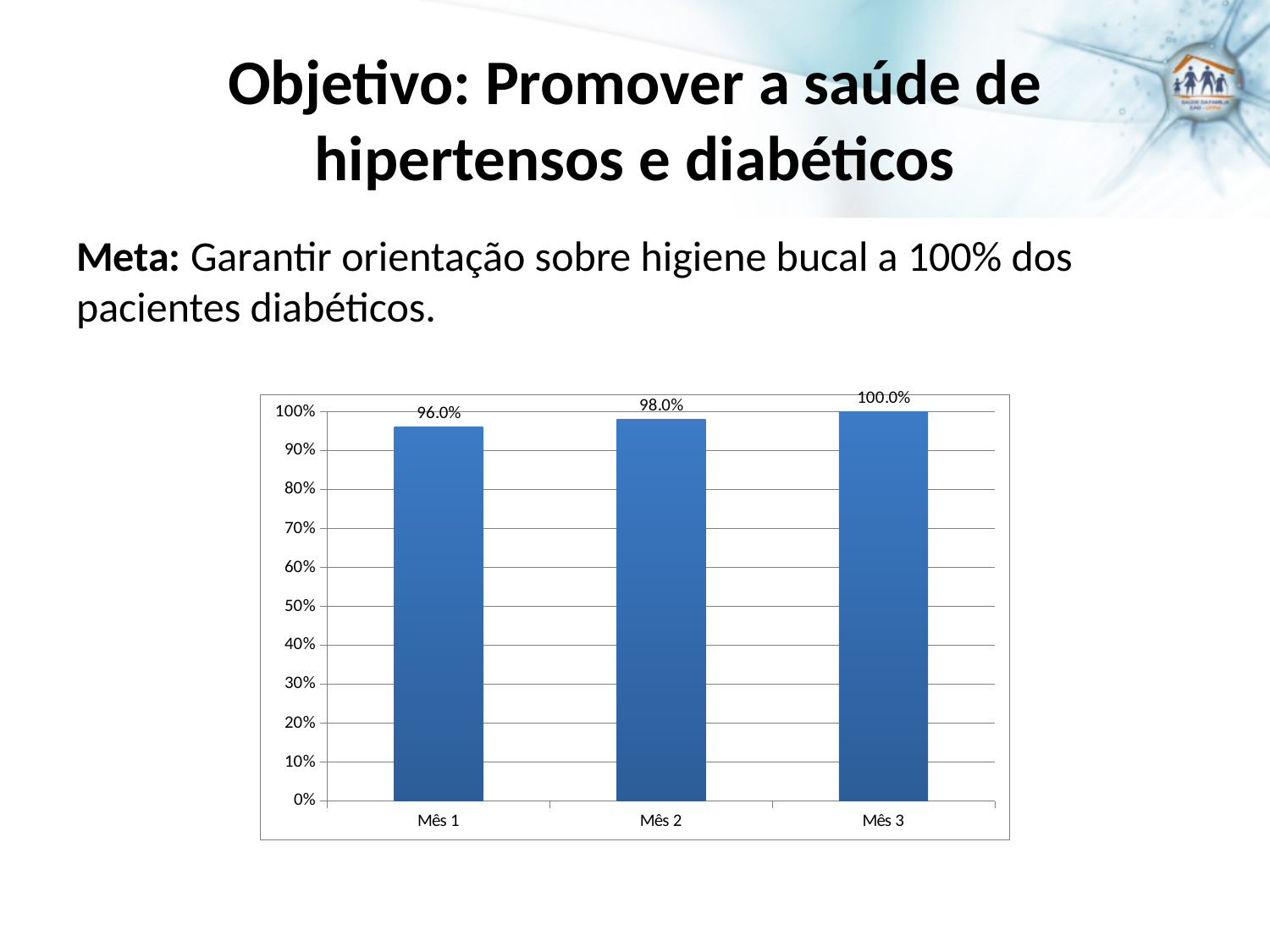
How many categories are shown on the x axis? 3 What is the value for Mês 3? 100.0% Is the value for Mês 1 greater or less than 90%? greater What is the difference between the values for Mês 3 and Mês 1? 4.0% Which is larger, the value for Mês 2 or the value for Mês 1? Mês 2 What kind of chart is shown on the slide? bar chart What is the difference between the values for Mês 2 and Mês 1? 2.0% Do the values rise or fall from Mês 1 to Mês 3? rise Which month has the lowest value? Mês 1 What is the value for Mês 2? 98.0% Which month has the highest value? Mês 3 What is the value for Mês 1? 96.0%